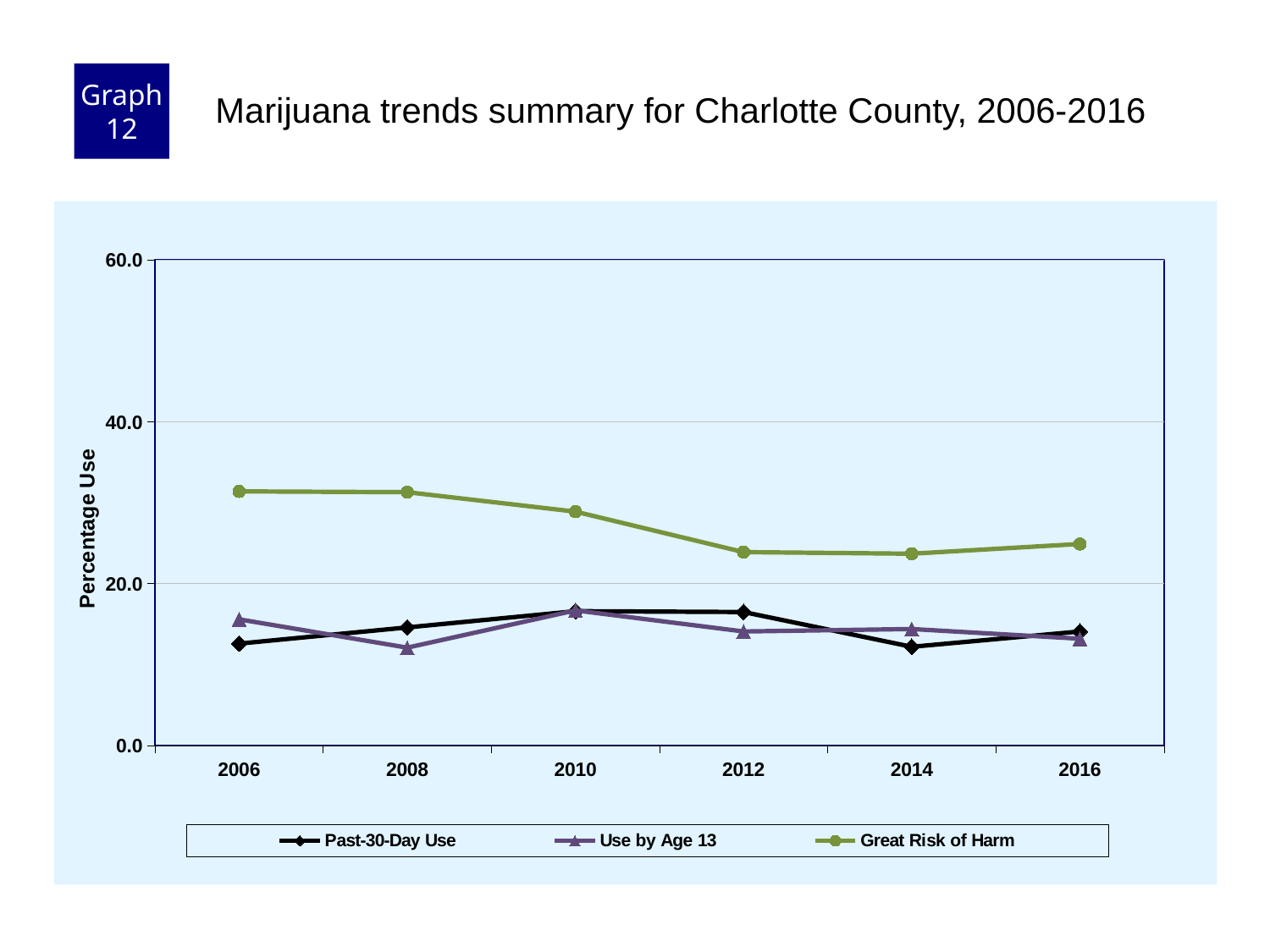
How many series does the legend list? 3 In 2012, which is larger: Great Risk of Harm or Past-30-Day Use? Great Risk of Harm How many years are plotted along the x axis? 6 What is the title of the chart? Marijuana trends summary for Charlotte County, 2006-2016 In 2006, which is larger: Use by Age 13 or Past-30-Day Use? Use by Age 13 What kind of chart is shown on the slide? Line chart Does the Great Risk of Harm line rise or fall from 2008 to 2014? Fall Is the value for Past-30-Day Use in 2006 greater or less than 20.0? less Which series has the highest values across all years? Great Risk of Harm What is the label on the y axis? Percentage Use Is the value for Great Risk of Harm in 2006 greater or less than 20.0? greater Is the value for Great Risk of Harm in 2008 greater or less than 40.0? less